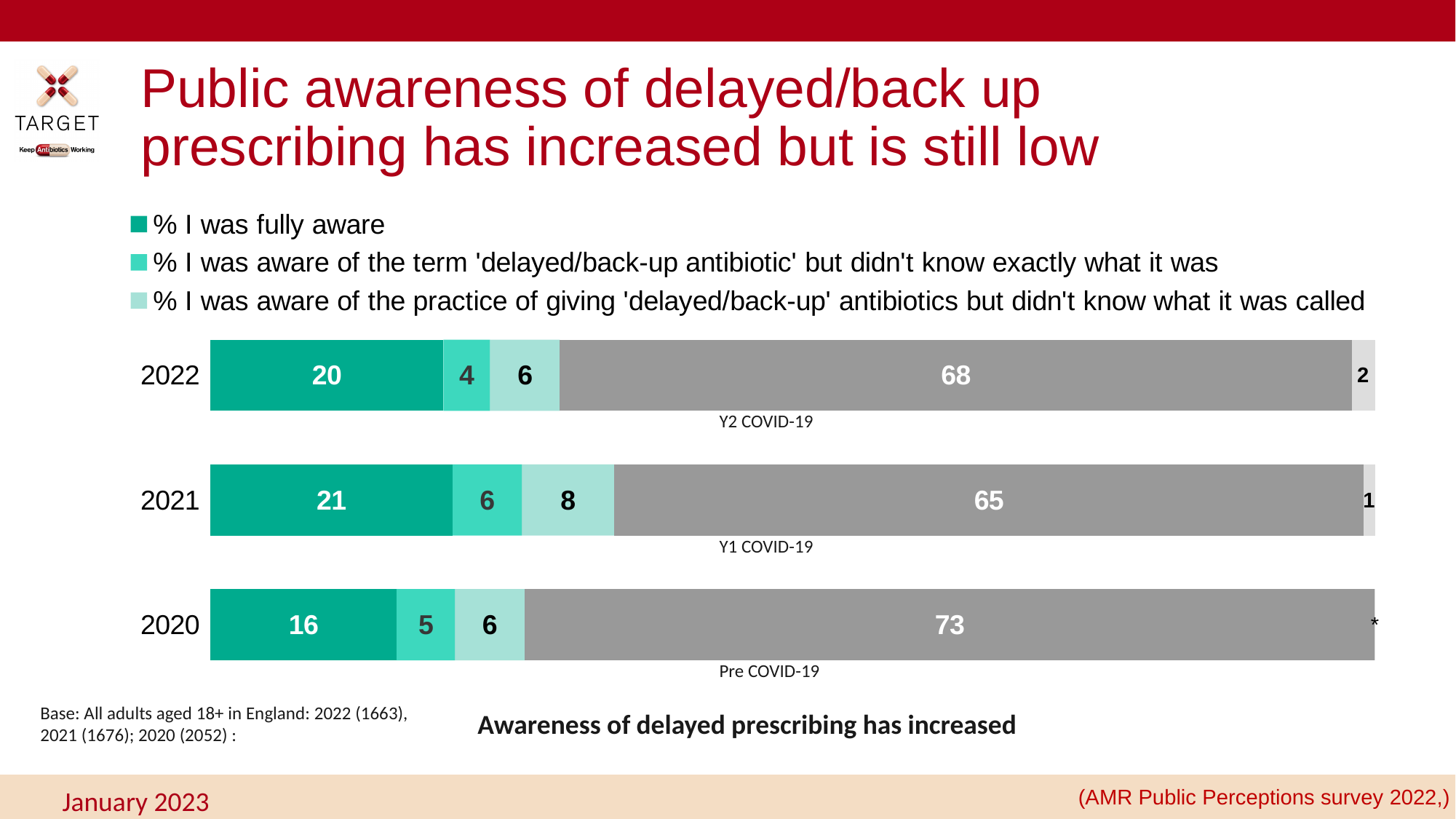
Which is larger: the '% I was aware of the term 'delayed/back-up antibiotic' but didn't know exactly what it was' value for 2021 or for 2022? 2021 What is the combined value of the three legend series for 2021? 35 How many series does the legend list? 3 What is the difference between the '% I was fully aware' values for 2021 and 2020? 5 Which year has the highest value for '% I was fully aware'? 2021 What is the value for '% I was aware of the term 'delayed/back-up antibiotic' but didn't know exactly what it was' in 2020? 5 What label appears beneath the 2020 bar? Pre COVID-19 Which year has the lowest value for '% I was fully aware'? 2020 What is the value for '% I was fully aware' in 2022? 20 How many years are shown on the chart? 3 What is the value for '% I was aware of the practice of giving 'delayed/back-up' antibiotics but didn't know what it was called' in 2021? 8 What kind of chart is shown on the slide? Stacked bar chart